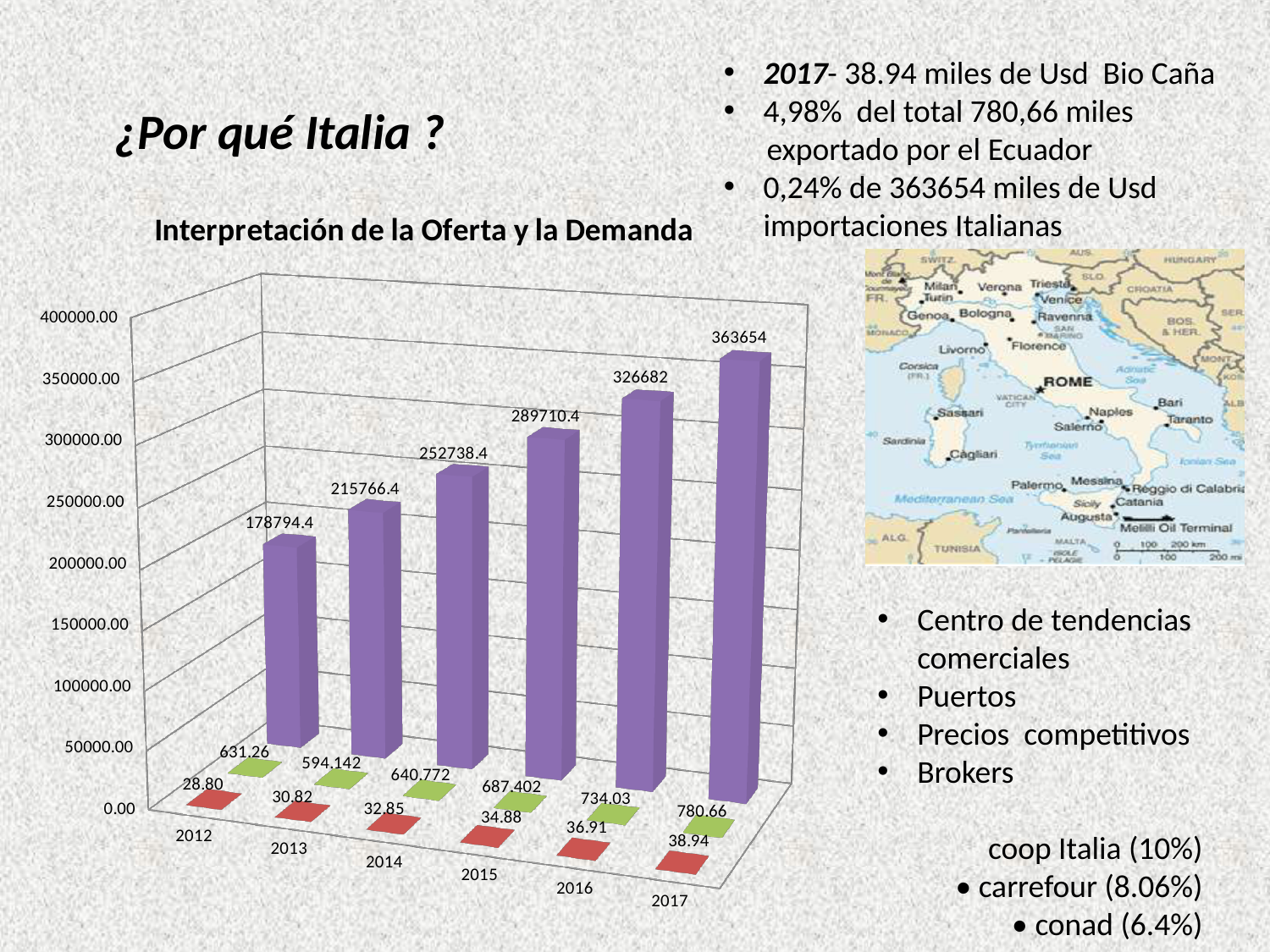
Do the purple bar values rise or fall from 2012 to 2017? rise What is the value of the red bar for 2014? 32.85 What is the value of the purple bar for 2017? 363654 What type of chart is shown on the slide? bar chart What is the value of the green bar for 2015? 687.402 Which year has the lowest green bar? 2013 Is the purple bar value for 2015 greater or less than 250000.00? greater What is the difference between the purple bar values for 2017 and 2016? 36972 What is the value of the purple bar for 2012? 178794.4 What is the title of the chart? Interpretación de la Oferta y la Demanda Which year has the highest purple bar? 2017 How many years are shown on the x axis of the chart? 6